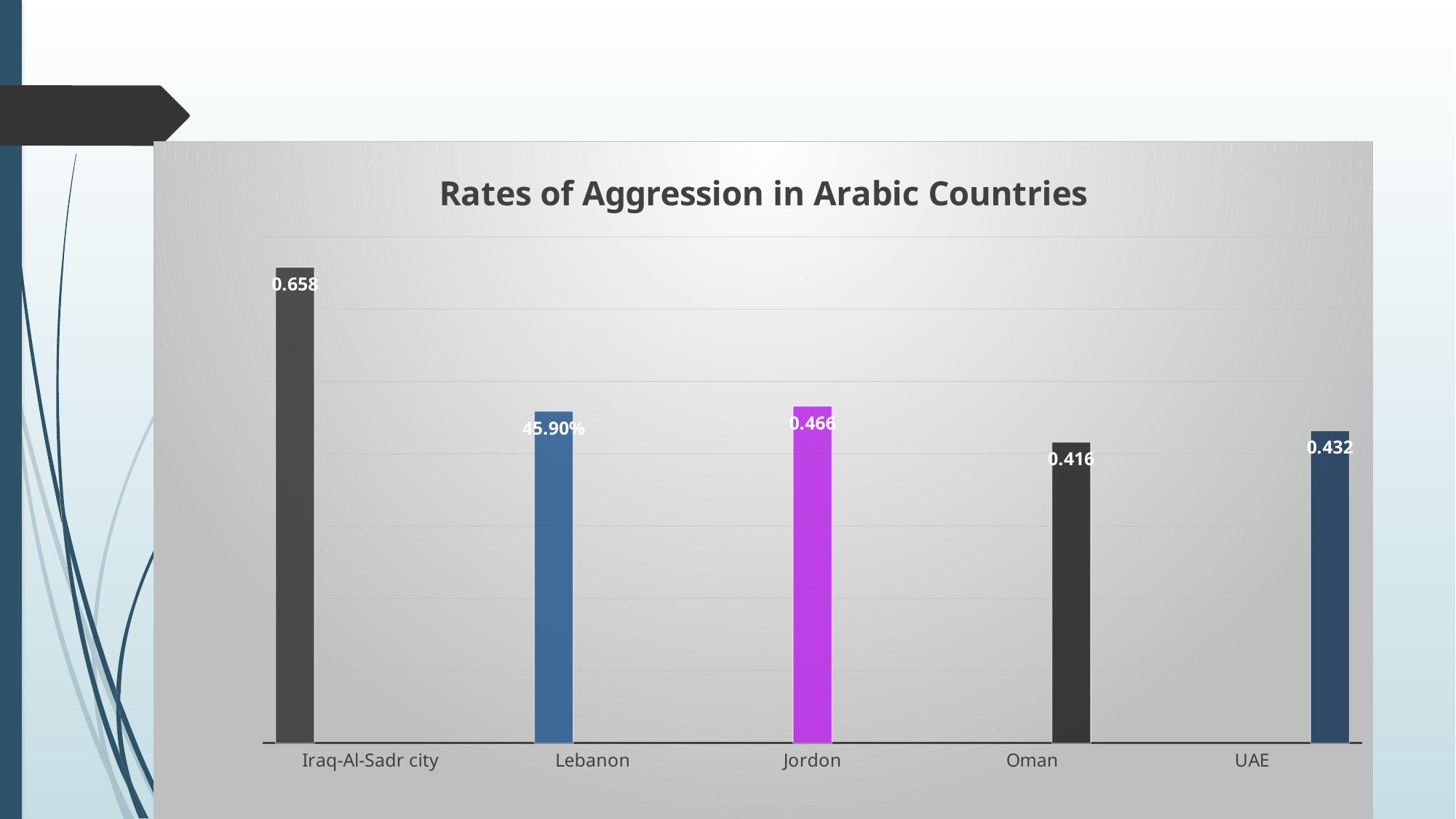
How many countries are shown in the chart? 5 What value is shown for Lebanon? 45.90% What is the value for Oman? 0.416 What is the value for Jordon? 0.466 What is the difference between the values for UAE and Oman? 0.016 What type of chart is shown on the slide? Bar chart Which country has the lowest value in the chart? Oman What is the value for UAE? 0.432 What is the value for Iraq-Al-Sadr city in the Rates of Aggression in Arabic Countries chart? 0.658 Which has a larger value, Jordon or Oman? Jordon Which country has the highest rate of aggression in the chart? Iraq-Al-Sadr city What is the difference between the values for Iraq-Al-Sadr city and Jordon? 0.192